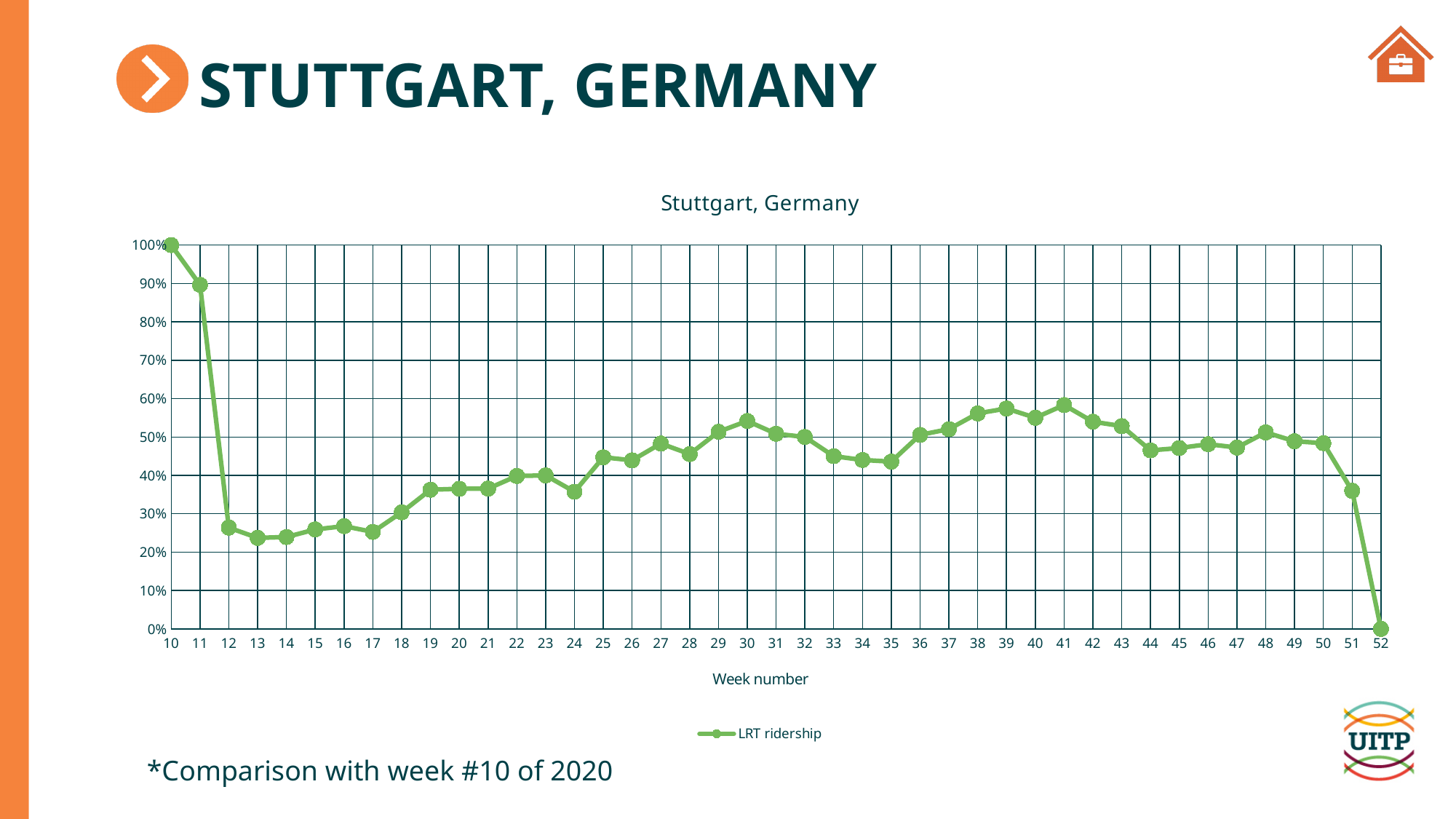
Is the LRT ridership value for week 41 greater or less than 50%? greater What is the LRT ridership value for week 10? 100% What is the LRT ridership value for week 52? 0% Which week has the lowest LRT ridership value? Week 52 Is the LRT ridership value for week 12 greater or less than 30%? less How many week numbers are plotted on the x axis? 43 What is the title of the chart? Stuttgart, Germany What type of chart is shown on the slide? Line chart Does LRT ridership rise or fall from week 10 to week 12? Fall How many series does the legend list? 1 Which week has the highest LRT ridership value? Week 10 What is the name of the series shown in the legend? LRT ridership